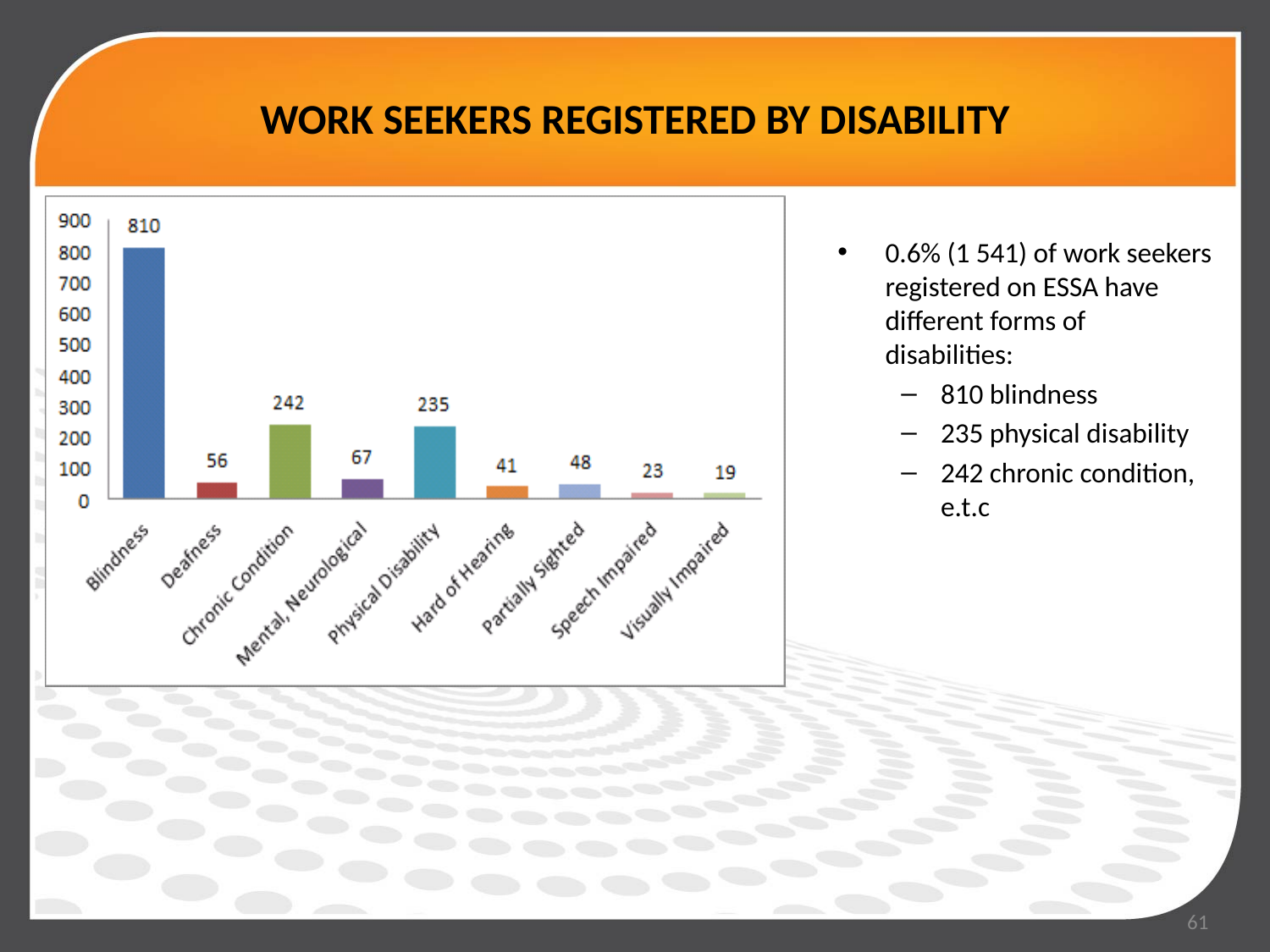
What is the value shown for Chronic Condition? 242 What is the value shown for Speech Impaired? 23 Which is larger, the value for Mental, Neurological or the value for Deafness? Mental, Neurological What is the difference between the values for Chronic Condition and Physical Disability? 7 What kind of chart is shown on the slide? Bar chart Which disability category has the highest number of registered work seekers? Blindness What is the difference between the values for Blindness and Deafness? 754 Which disability category has the lowest number of registered work seekers? Visually Impaired How many disability categories are shown on the x axis? 9 What is the number of work seekers registered with Blindness? 810 Is the value for Physical Disability greater or less than 200? greater What is the value shown for Hard of Hearing? 41